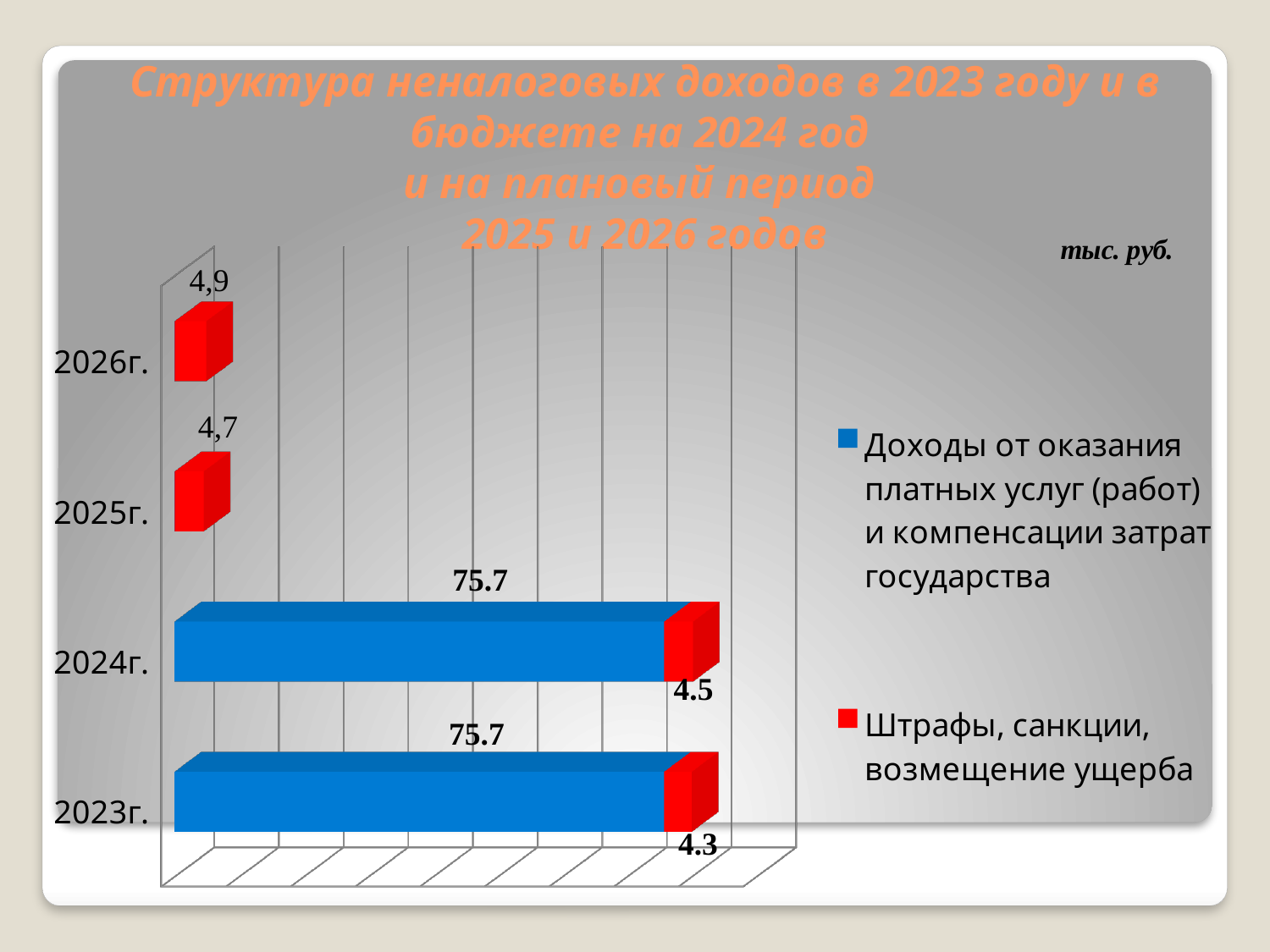
What is the difference between the 'Штрафы, санкции, возмещение ущерба' values for 2024г. and 2023г.? 0.2 Which year has the highest value for 'Штрафы, санкции, возмещение ущерба'? 2026г. What type of chart is shown on the slide? bar chart What is the value of 'Штрафы, санкции, возмещение ущерба' for 2026г.? 4,9 How many series does the legend list? 2 What is the value of 'Доходы от оказания платных услуг (работ) и компенсации затрат государства' for 2024г.? 75.7 Which year has the lowest value for 'Штрафы, санкции, возмещение ущерба'? 2023г. What is the total of the stacked bar for 2023г.? 80.0 How many year categories are shown on the chart? 4 What unit of measurement is indicated on the chart? тыс. руб. What is the value of 'Штрафы, санкции, возмещение ущерба' for 2025г.? 4,7 What is the value of 'Штрафы, санкции, возмещение ущерба' for 2023г.? 4.3